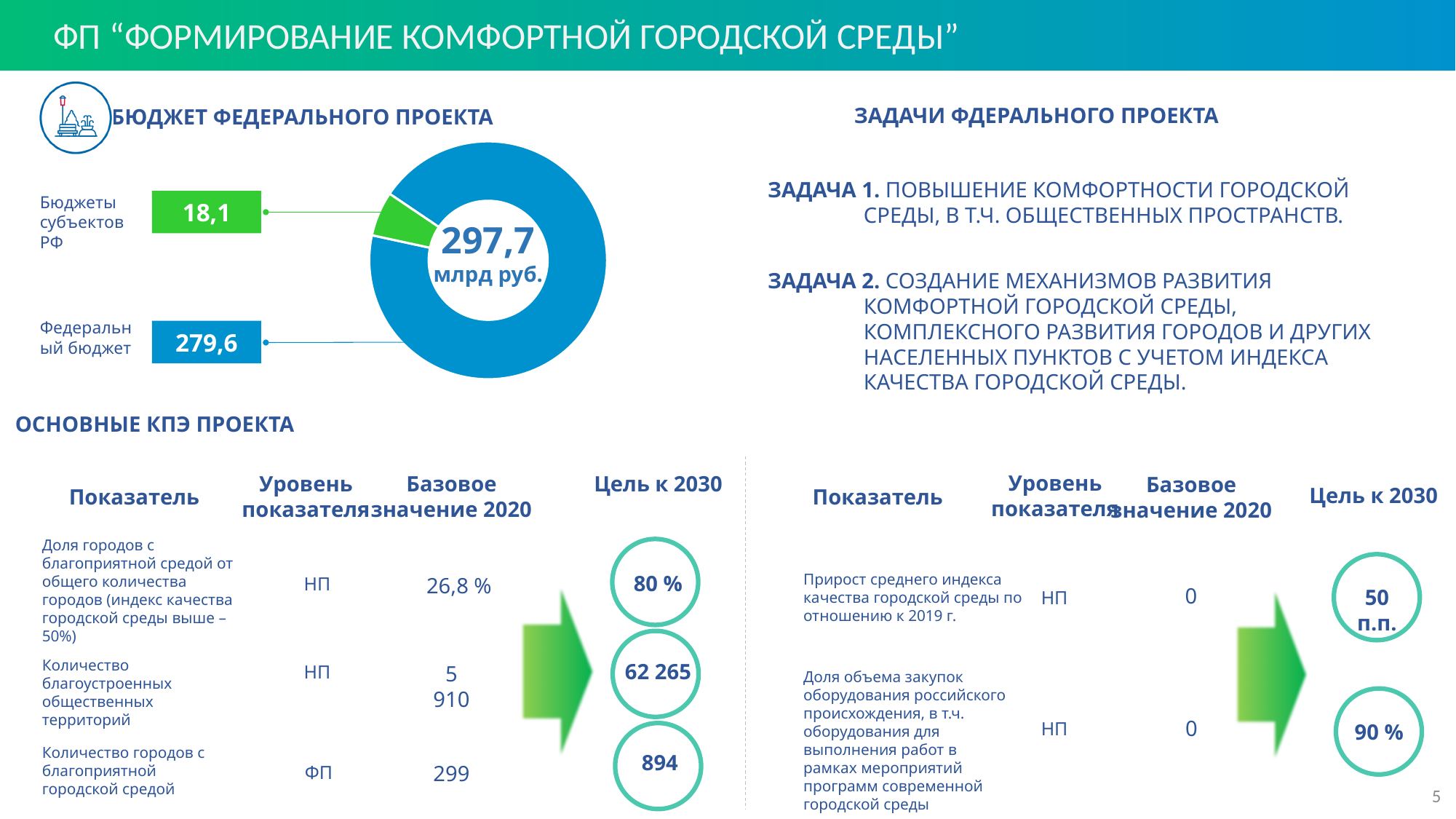
What is the difference between the Федеральный бюджет and Бюджеты субъектов РФ values in the budget chart? 261,5 What is the value shown for Федеральный бюджет in the budget chart? 279,6 What is the value shown for Бюджеты субъектов РФ in the budget chart? 18,1 How many budget components are shown in the budget chart? 2 What kind of chart is used to show the federal project budget? pie chart (donut) What total is shown in the centre of the budget donut chart? 297,7 млрд руб. Which budget component is the largest in the budget chart? Федеральный бюджет What is the title of the section containing the budget chart? БЮДЖЕТ ФЕДЕРАЛЬНОГО ПРОЕКТА Which budget component is the smallest in the budget chart? Бюджеты субъектов РФ What colour is the Бюджеты субъектов РФ segment in the budget chart? green Which is larger in the budget chart: Бюджеты субъектов РФ or Федеральный бюджет? Федеральный бюджет